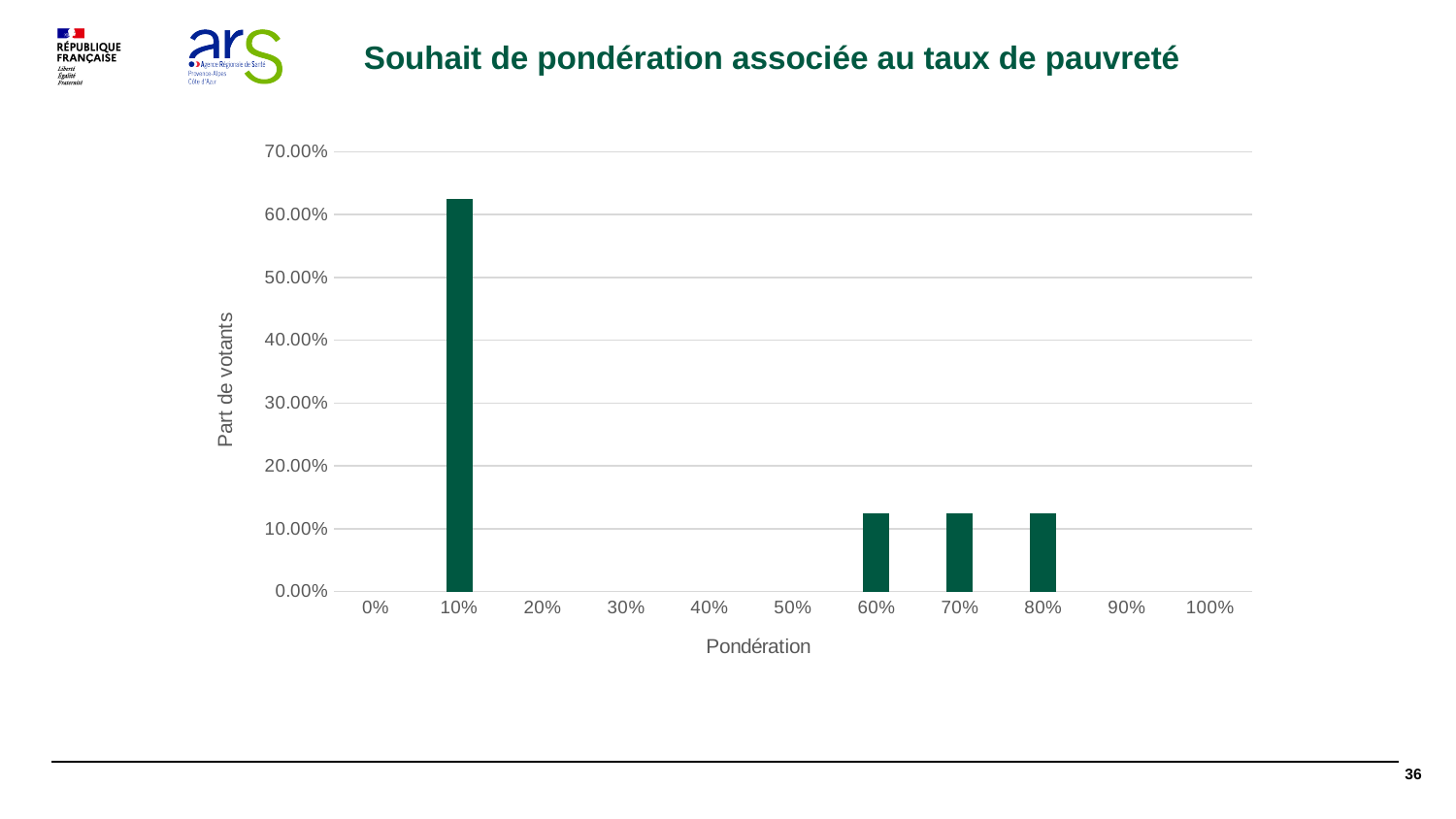
Which category has the highest share of voters? 10% Which has a larger share of voters, the 80% category or the 90% category? 80% How many categories are shown on the x axis? 11 Is the value for the 60% category greater or less than 20.00%? less What is the title of the chart? Souhait de pondération associée au taux de pauvreté Is the value for the 10% category greater or less than 50.00%? greater Is the value for the 80% category greater or less than 30.00%? less What is the label of the x axis? Pondération What kind of chart is shown on the slide? bar chart Which has a larger share of voters, the 10% category or the 70% category? 10% How many categories have a visible bar (a non-zero value)? 4